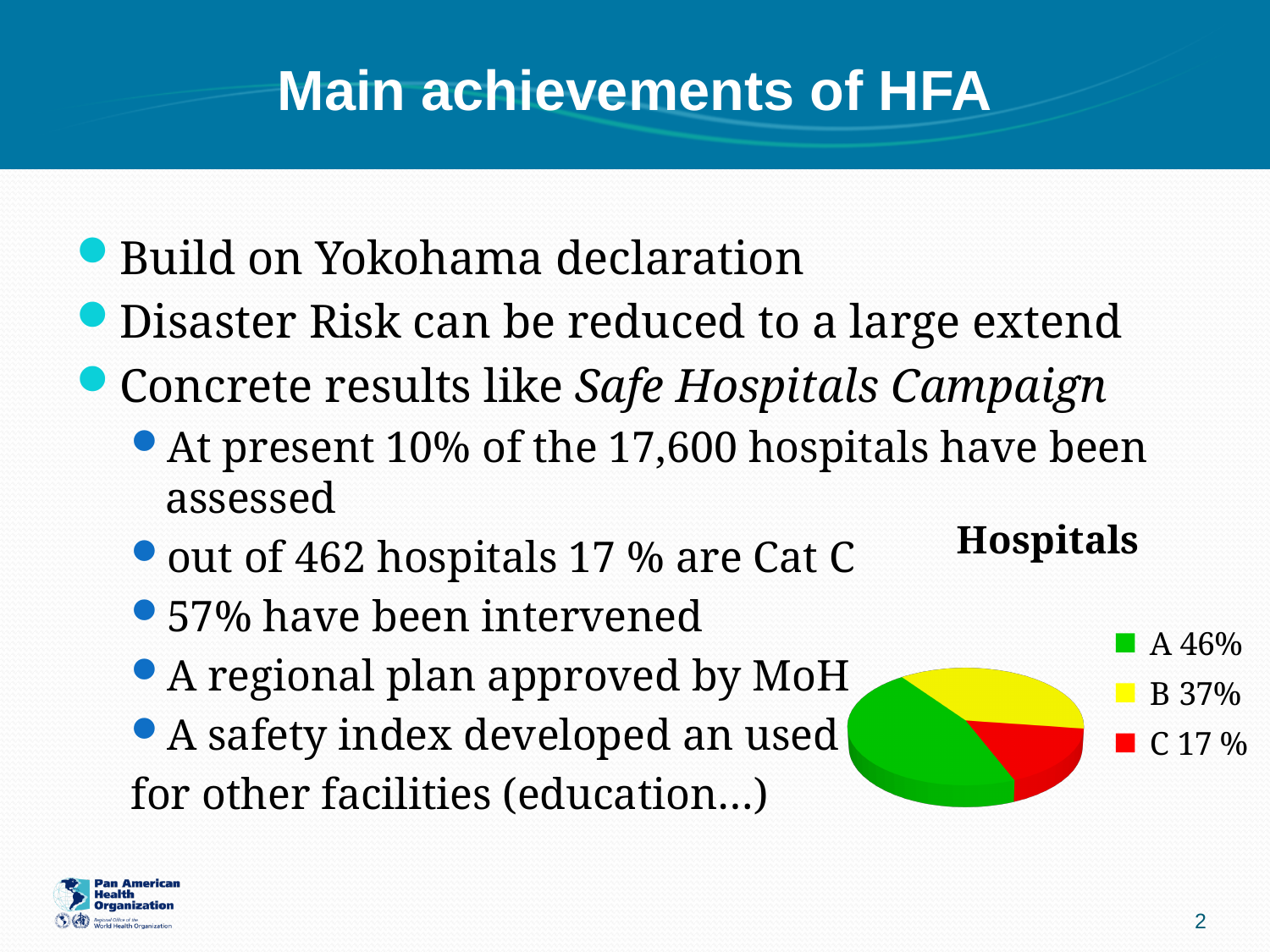
What share of the pie does category B have? 37% By how many percentage points does A's share exceed B's share? 9 Which category has the smallest slice of the pie? C How many slices does the pie chart have? 3 By how many percentage points does B's share exceed C's share? 20 What colour is the slice for category C? red What share of the pie does category A have? 46% Which category has the largest slice of the pie? A What is the title of the chart? Hospitals What share of the pie does category C have? 17 % Which is larger, the share for B or the share for C? B What kind of chart is shown on the slide? pie chart